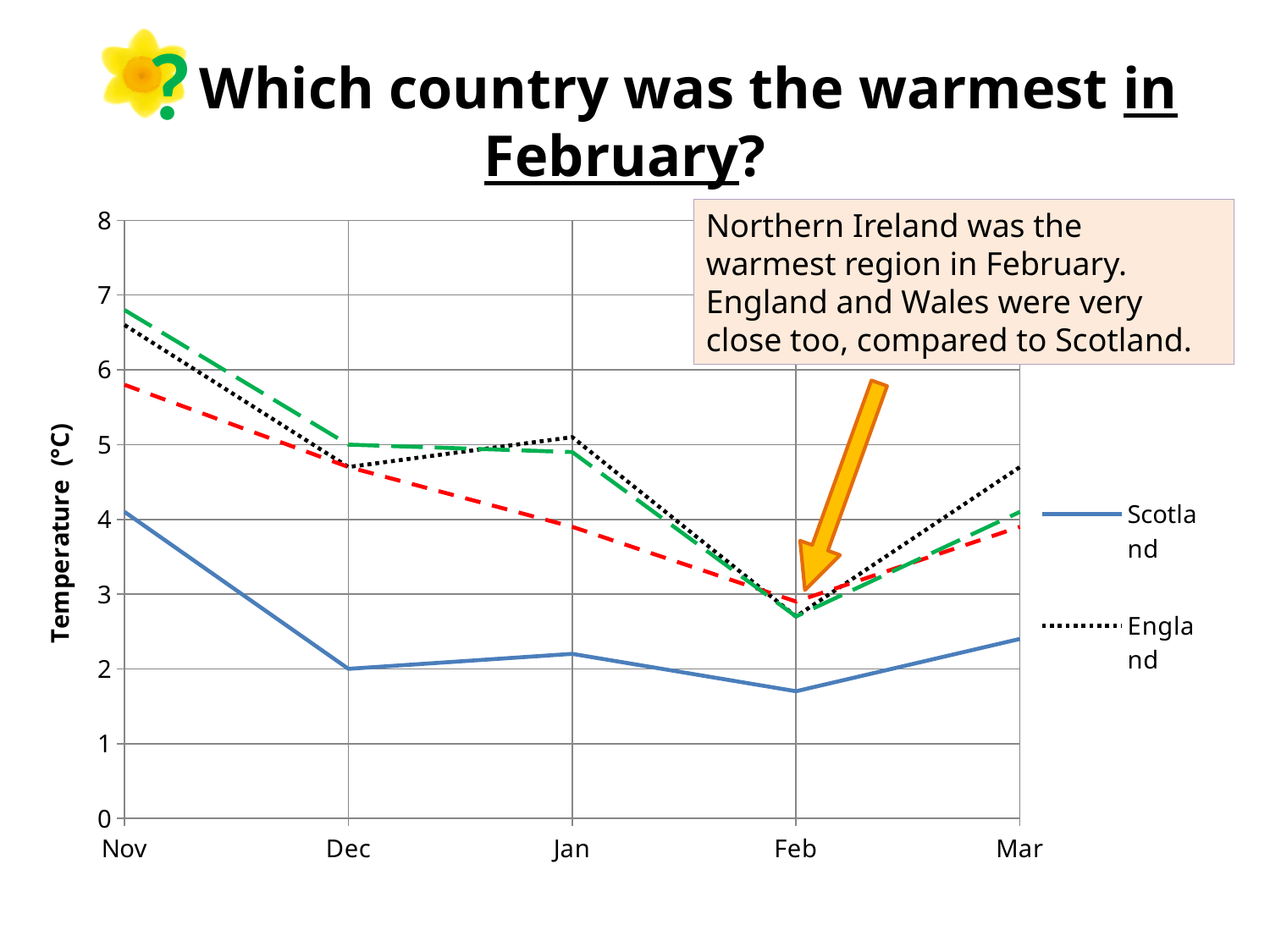
How many months are shown along the x axis of the chart? 5 In Feb, which is higher, England or Scotland? England Is the value for Scotland in Feb greater or less than 2? less What kind of chart is shown on the slide? line chart Is the value for England in Mar greater or less than 4? greater How many lines are plotted on the chart? 4 What is the title of the vertical axis of the chart? Temperature (°C) Is the value for Scotland in Nov greater or less than 3? greater In which month is the England line at its highest? Nov Which series is drawn as a solid blue line? Scotland In which month is the Scotland line at its lowest? Feb